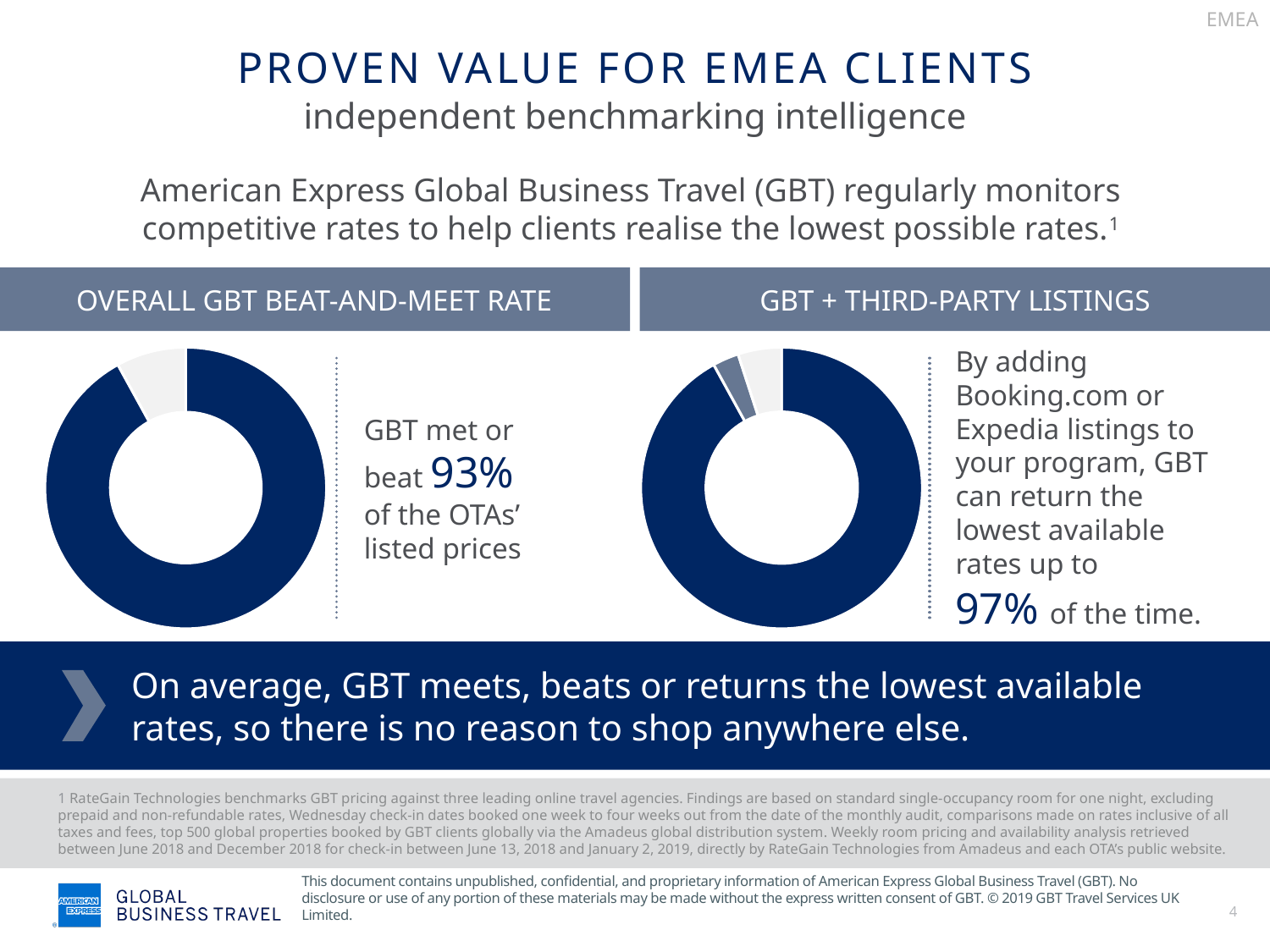
In the GBT + THIRD-PARTY LISTINGS chart, up to what percentage of the time can GBT return the lowest available rates? 97% How many segments does the OVERALL GBT BEAT-AND-MEET RATE donut chart have? 2 What is the difference in percentage points between the 97% in the GBT + THIRD-PARTY LISTINGS chart and the 93% in the OVERALL GBT BEAT-AND-MEET RATE chart? 4 percentage points What kind of chart is shown under the heading GBT + THIRD-PARTY LISTINGS? Donut (pie) chart How many segments does the GBT + THIRD-PARTY LISTINGS donut chart have? 3 What kind of chart is shown under the heading OVERALL GBT BEAT-AND-MEET RATE? Donut (pie) chart In the OVERALL GBT BEAT-AND-MEET RATE chart, what percentage of the OTAs' listed prices did GBT meet or beat? 93% What share of the OVERALL GBT BEAT-AND-MEET RATE donut does the dark blue segment represent? 93% Is the dark blue share in the OVERALL GBT BEAT-AND-MEET RATE chart greater or less than 50%? greater What is the heading above the left-hand donut chart? OVERALL GBT BEAT-AND-MEET RATE